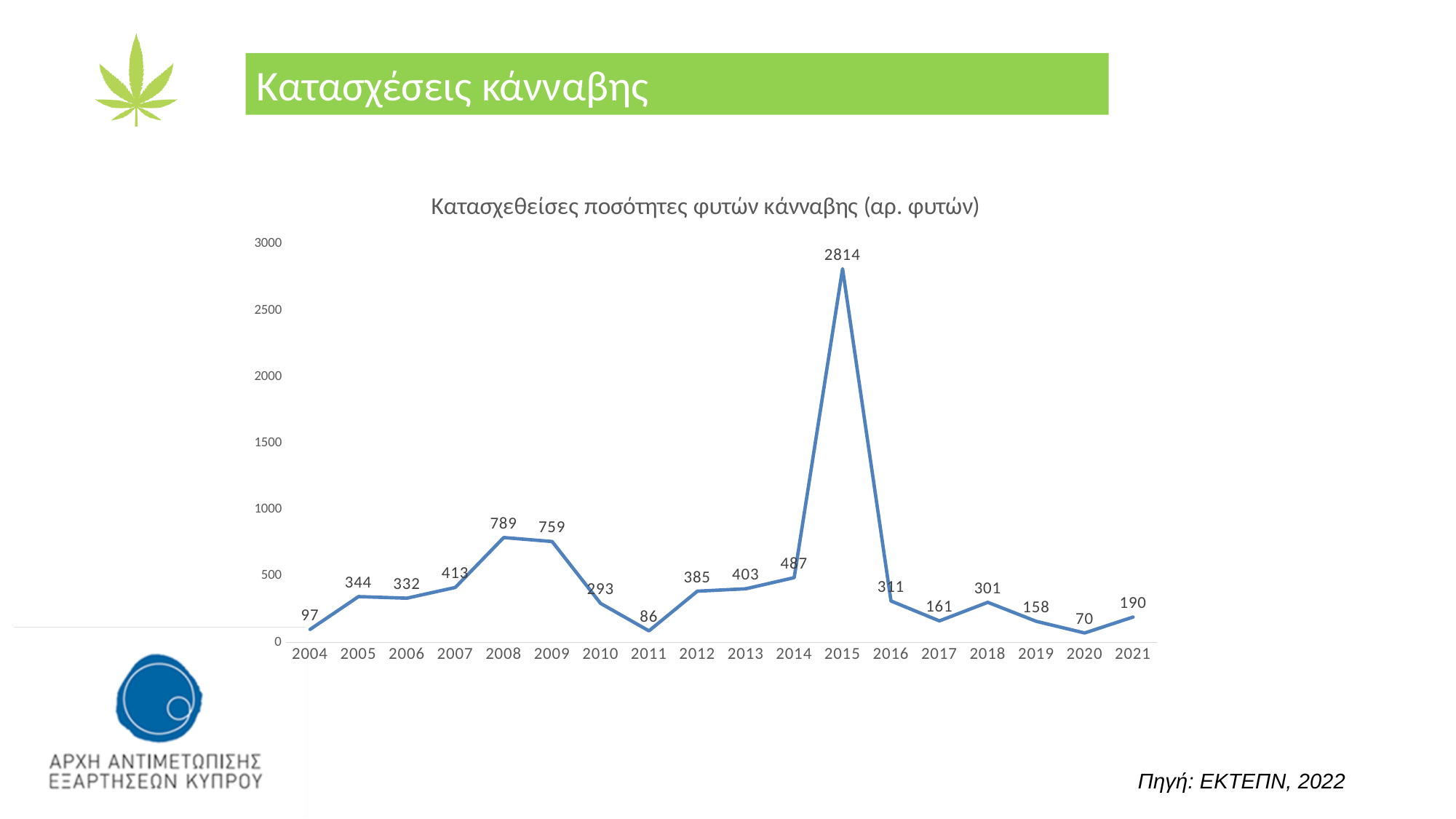
What is the title of the chart? Κατασχεθείσες ποσότητες φυτών κάνναβης (αρ. φυτών) Is the value for 2014 greater or less than 1000? less What is the difference between the values for 2008 and 2009? 30 Which is larger, the value for 2012 or the value for 2013? 2013 Which year has the highest value? 2015 Do the values rise or fall from 2015 to 2016? fall Which year has the lowest value? 2020 What is the value for 2008? 789 What is the value for 2020? 70 What is the value for 2015? 2814 How many years are plotted on the x axis? 18 What kind of chart is shown? line chart